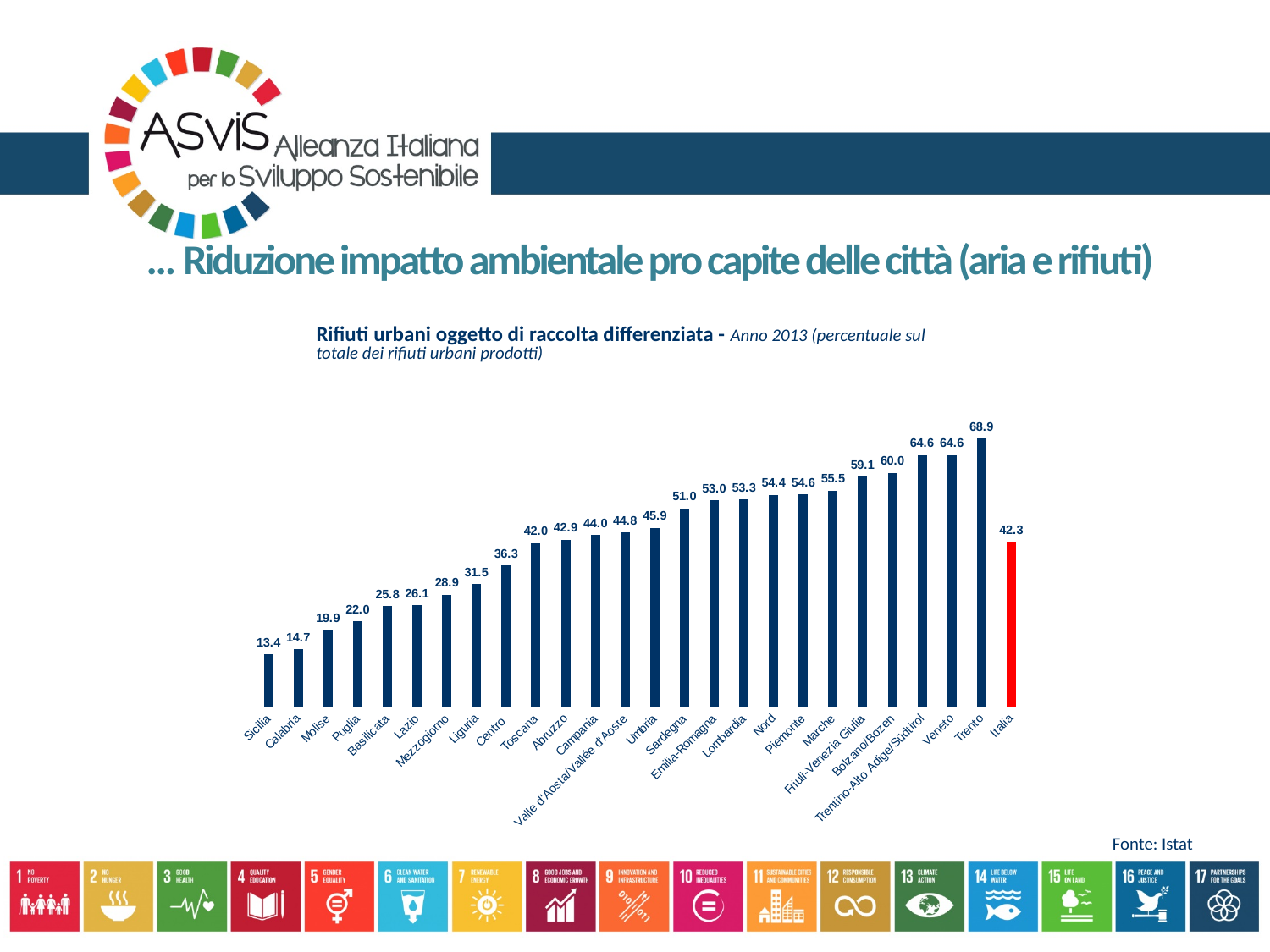
Which is larger, the value for Nord or the value for Mezzogiorno? Nord Which category has the highest value? Trento How many categories are shown on the x axis? 26 Which bar is coloured red instead of blue? Italia What is the difference between the values for Veneto and Italia? 22.3 What is the value for Trento? 68.9 What is the value for Italia? 42.3 Which category has the lowest value? Sicilia What is the value for Lombardia? 53.3 What is the difference between the values for Trento and Sicilia? 55.5 What kind of chart is this? Bar chart What is the value for Sicilia? 13.4